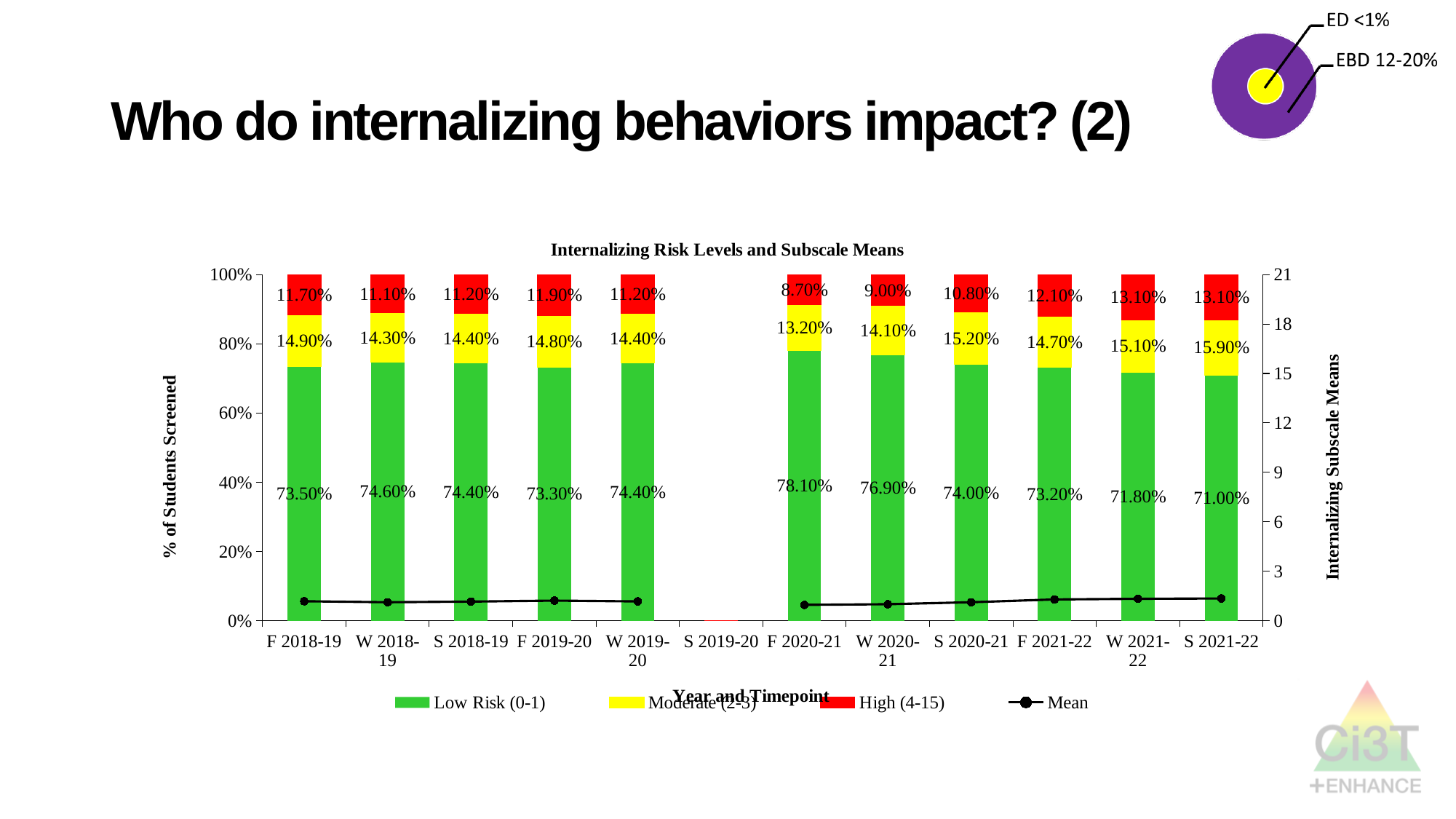
What kind of chart is shown? Stacked bar chart with a line Which timepoint has the highest Low Risk (0-1) percentage? F 2020-21 What is the High (4-15) value for S 2021-22? 13.10% What is the difference between the Low Risk (0-1) values for F 2020-21 and S 2021-22? 7.10% Which timepoint has the lowest High (4-15) percentage? F 2020-21 Which is larger, the High (4-15) value for F 2021-22 or for W 2020-21? F 2021-22 Which timepoint has the highest Moderate (2-3) percentage? S 2021-22 What is the Moderate (2-3) value for F 2019-20? 14.80% How many series does the legend list? 4 Is the Mean value for S 2021-22 greater or less than 3 on the right-hand axis? less From F 2020-21 to S 2021-22, does the Low Risk (0-1) percentage rise or fall? fall What is the Low Risk (0-1) value for F 2020-21? 78.10%